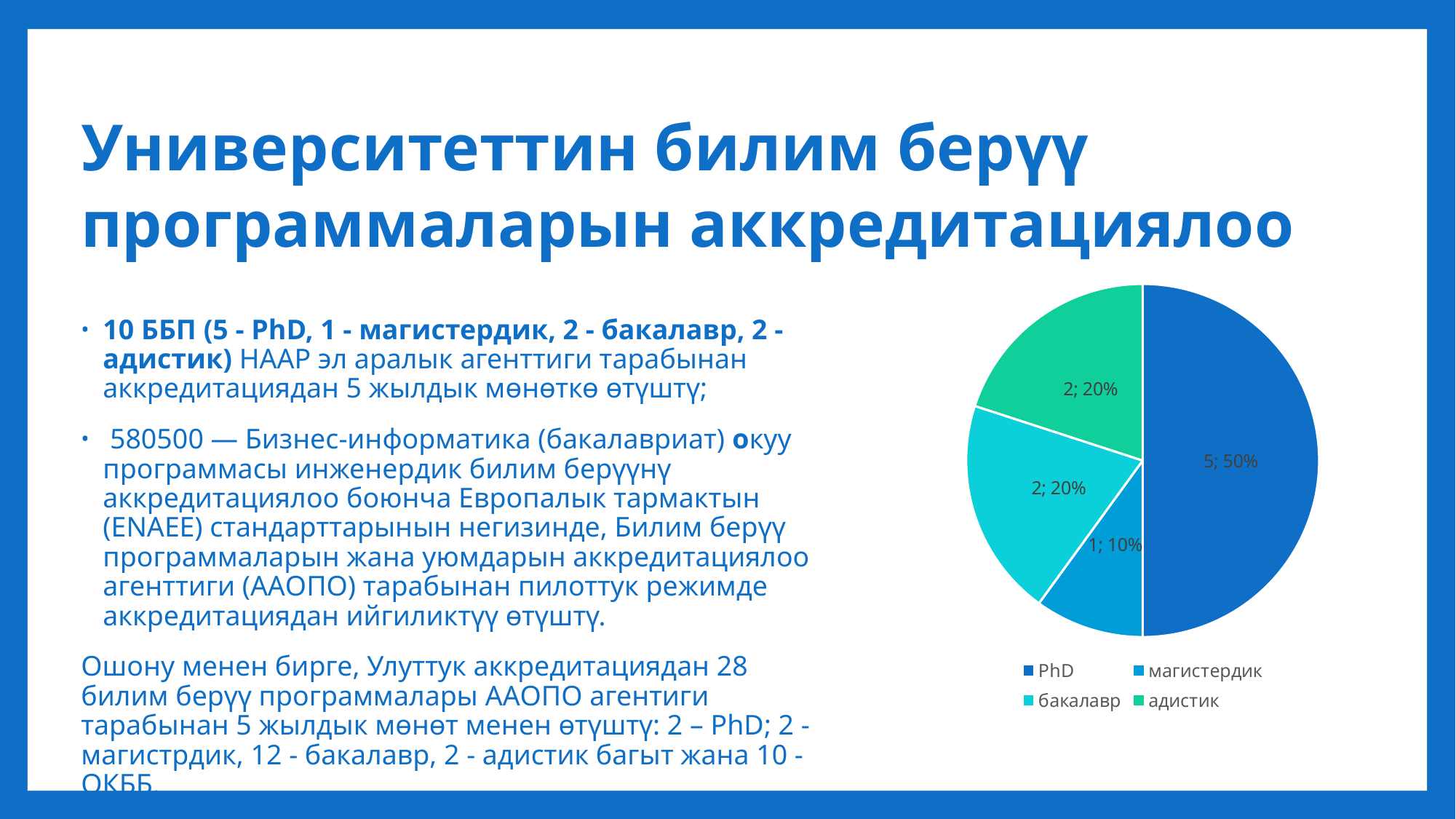
How many slices does the pie chart have? 4 What share of the pie does the адистик slice represent? 20% How many entries does the legend of the pie chart list? 4 What kind of chart is shown on the slide? pie chart What is the difference between the PhD value and the магистердик value in the pie chart? 4 What value is shown for the PhD slice of the pie chart? 5 Which is larger in the pie chart, the PhD slice or the бакалавр slice? PhD Which category has the largest slice in the pie chart? PhD What value is shown for the бакалавр slice of the pie chart? 2 What value is shown for the магистердик slice of the pie chart? 1 Which category has the smallest slice in the pie chart? магистердик What share of the pie does the PhD slice represent? 50%